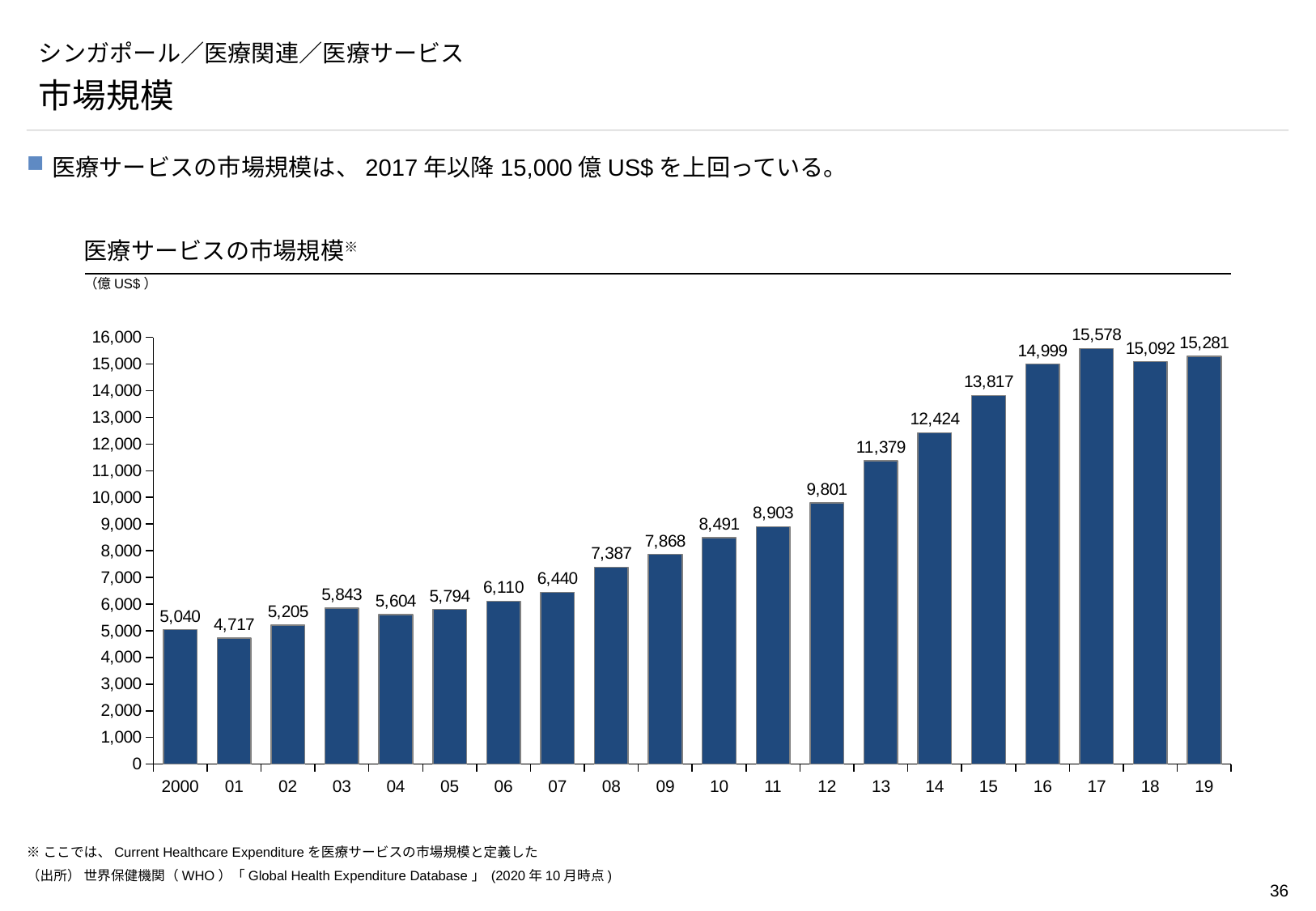
What unit is shown for the chart's values? 億 US$ Is the value for 2012 greater or less than 10,000? less What is the value for 2019? 15,281 What kind of chart is this? bar chart What is the value for 2013? 11,379 Which year has the lowest value? 2001 Do the values generally rise or fall from 2001 to 2017? rise What is the difference between the values for 2017 and 2018? 486 Which is larger, the value for 2003 or the value for 2004? 2003 How many years are shown on the x axis? 20 Which year has the highest value? 2017 What is the value for 2000? 5,040